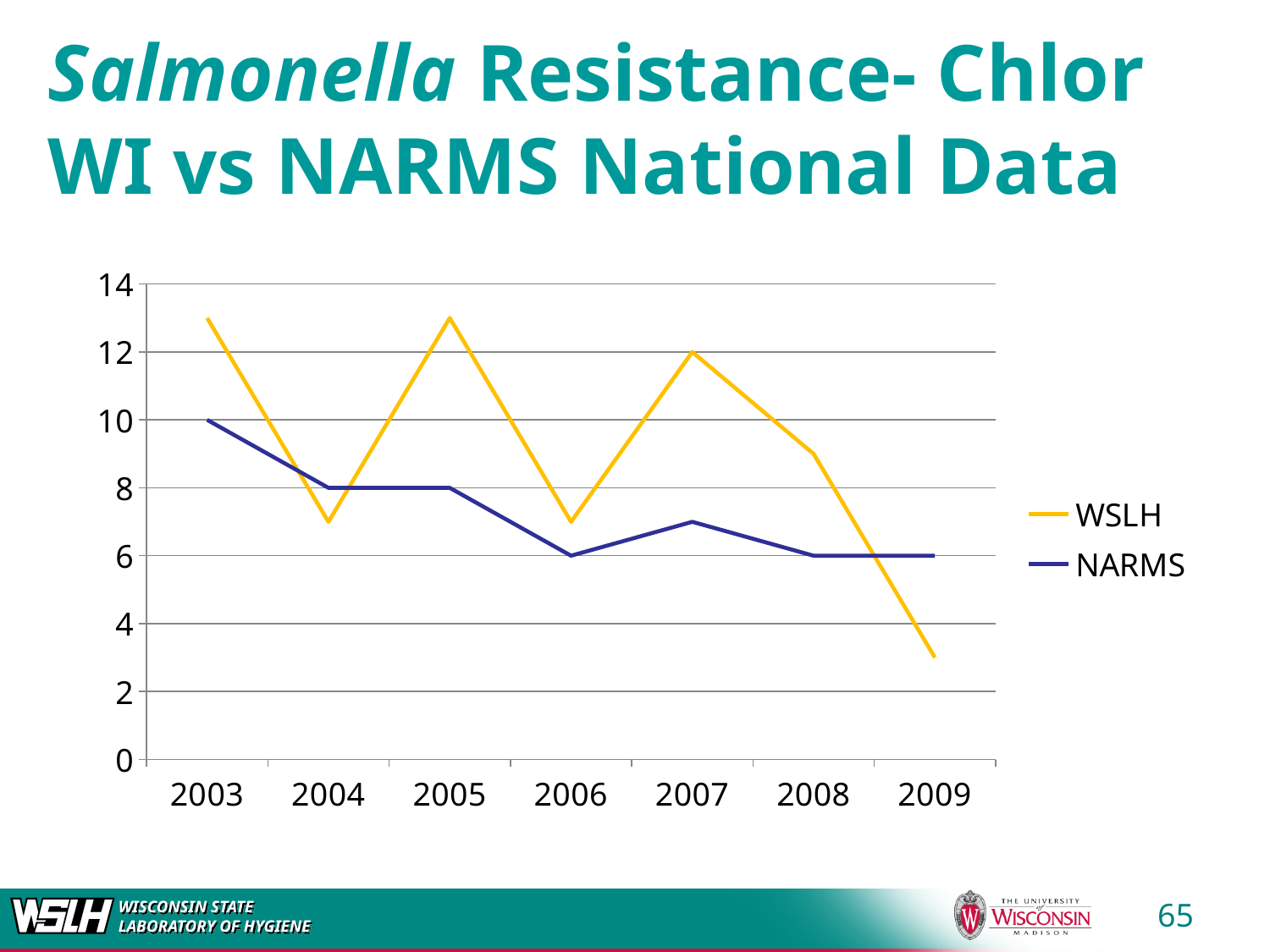
What kind of chart is shown on the slide? line chart What is the difference between the NARMS value in 2003 and the NARMS value in 2009? 4 What is the NARMS value for 2003? 10 Is the WSLH value for 2003 greater or less than 12? greater In which year is the WSLH value lowest? 2009 In 2009, which series has the larger value, WSLH or NARMS? NARMS What is the WSLH value for 2007? 12 What is the NARMS value for 2009? 6 How many series does the legend list? 2 Is the WSLH value for 2009 greater or less than 4? less In which year is the NARMS value highest? 2003 How many years are plotted along the x axis? 7